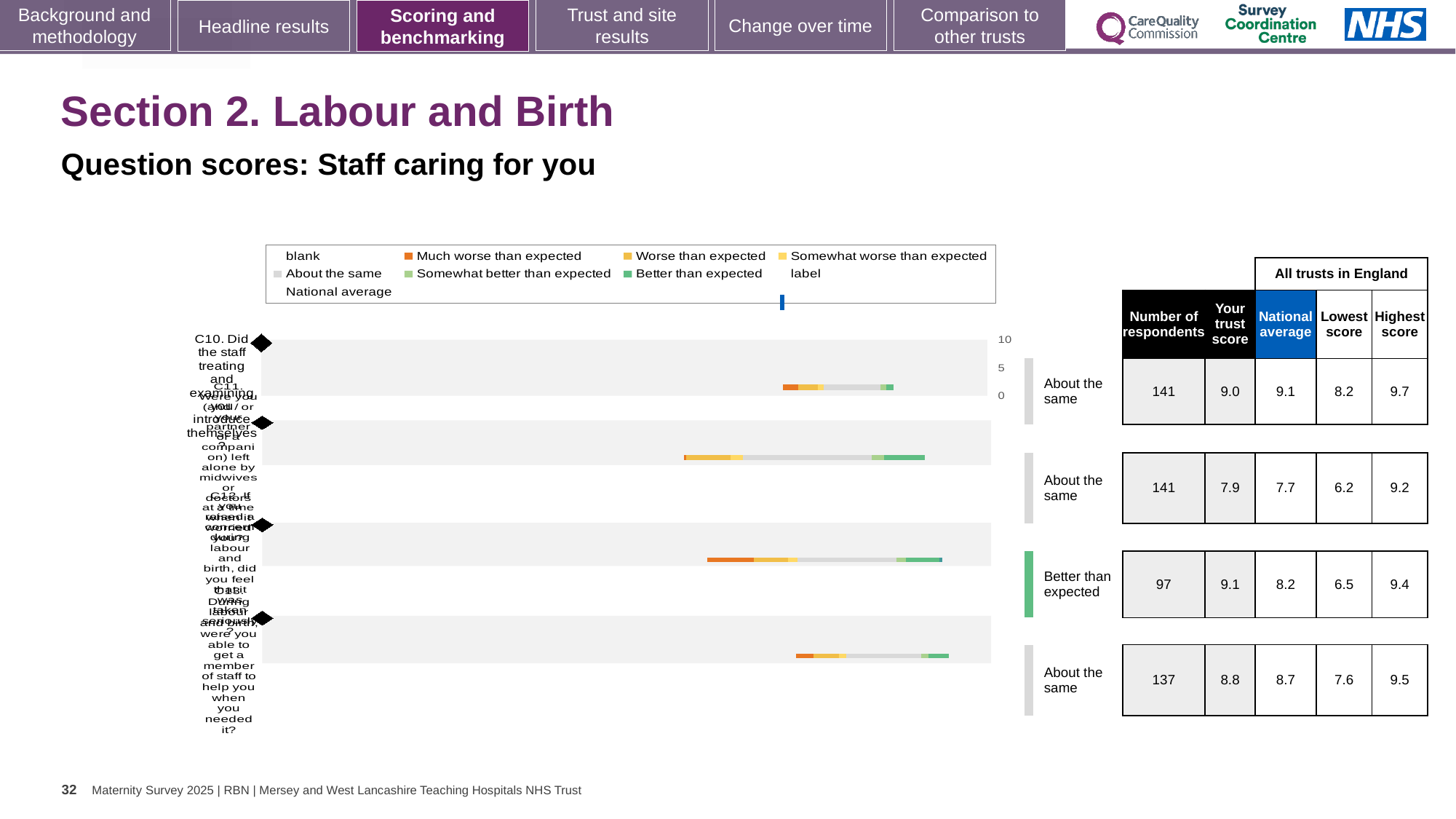
Which row has the lowest 'Your trust score'? Second row (C11), 7.9 For the third row (C12), what is the difference between 'Your trust score' and the national average? 0.9 What is the benchmark rating shown for the fourth row (C13)? About the same What is the highest score among all trusts in England for the fourth row (C13)? 9.5 What is the number of respondents for the first row (C10)? 141 What is the 'Your trust score' value for the third row (C12)? 9.1 Which row has the highest 'Your trust score'? Third row (C12), 9.1 What kind of chart is shown on the slide? Bar chart What is the lowest score among all trusts in England for the second row (C11)? 6.2 For the second row (C11), which is larger: 'Your trust score' or the national average? Your trust score (7.9) How many rows are rated 'Better than expected'? 1 How many question rows are plotted in the chart? 4